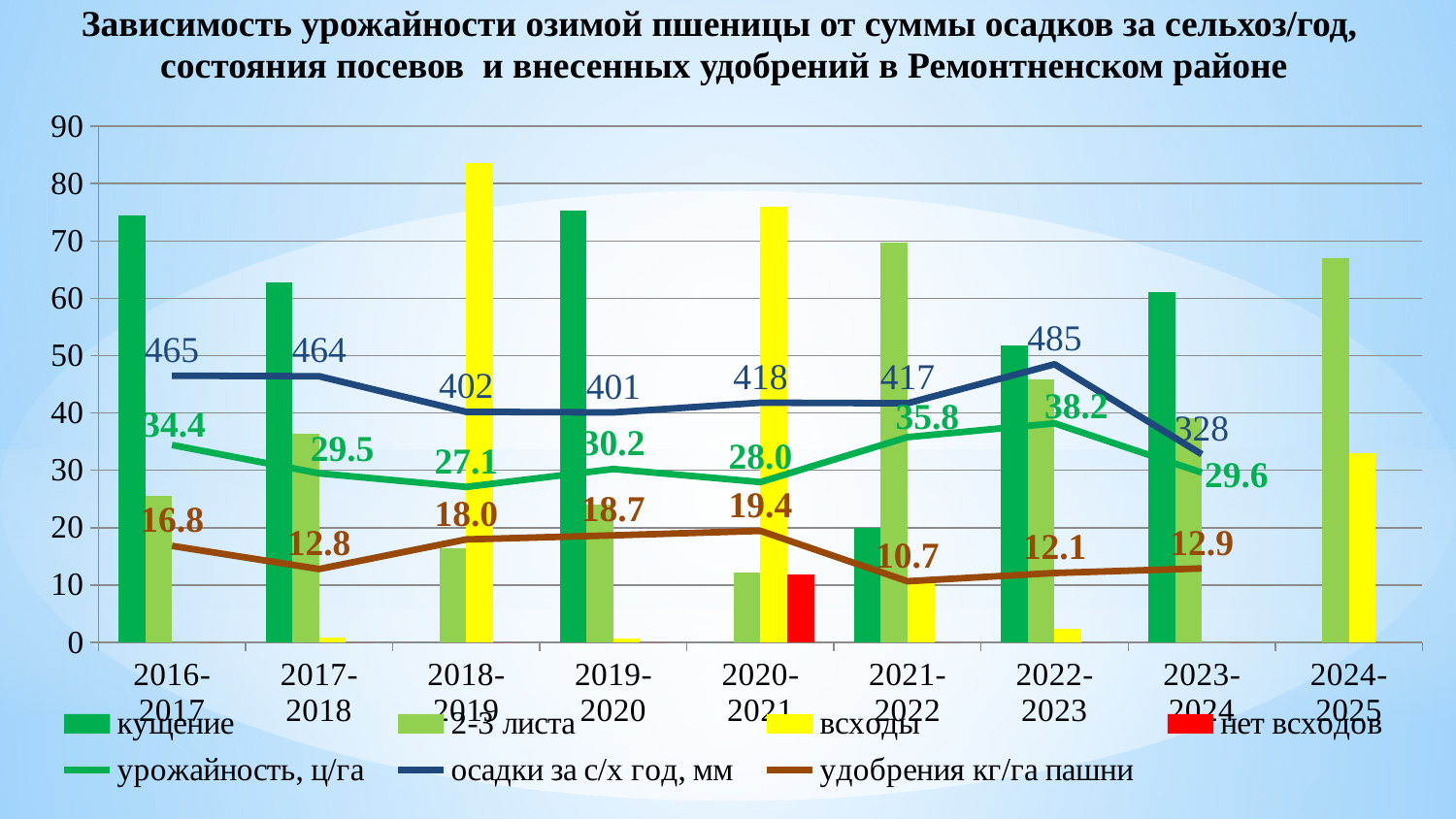
What is the удобрения кг/га пашни value for 2020-2021? 19.4 What is the урожайность, ц/га value for 2022-2023? 38.2 In which season is удобрения кг/га пашни the lowest? 2021-2022 How many series does the legend list? 7 What is the value of осадки за с/х год, мм for 2016-2017? 465 In which season is урожайность, ц/га the highest? 2022-2023 How many seasons are shown on the x axis? 9 What is the difference between осадки за с/х год, мм in 2016-2017 and in 2023-2024? 137 Which is larger: урожайность, ц/га in 2021-2022 or in 2017-2018? 2021-2022 Is the кущение bar for 2016-2017 greater or less than 70? greater In which season is осадки за с/х год, мм the lowest? 2023-2024 Is the всходы bar for 2018-2019 greater or less than 80? greater